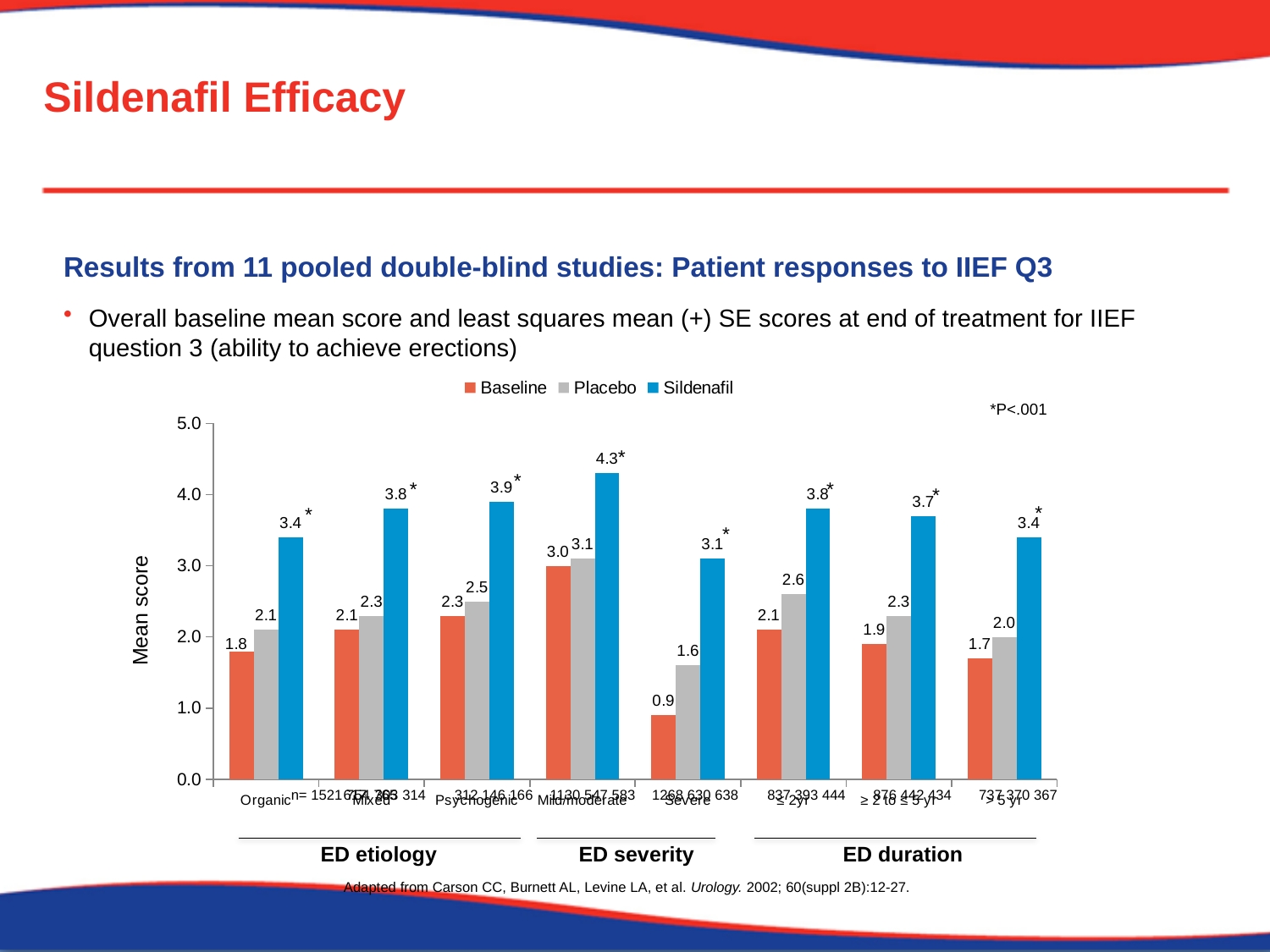
Which category has the lowest Baseline value? Severe Which series is shown in blue in the legend? Sildenafil What is the Placebo value for the Psychogenic category? 2.5 Which category has the highest Sildenafil value? Mild/moderate What is the Sildenafil value for the Mild/moderate category? 4.3 What is the difference between the Baseline values for Mild/moderate and Severe? 2.1 What kind of chart is shown on the slide? Bar chart What is the Baseline value for the Severe category? 0.9 What is the difference between the Sildenafil and Placebo values for the Severe category? 1.5 What is the label of the y axis? Mean score How many series does the legend list? 3 Which is larger for the Organic category, the Placebo value or the Sildenafil value? Sildenafil